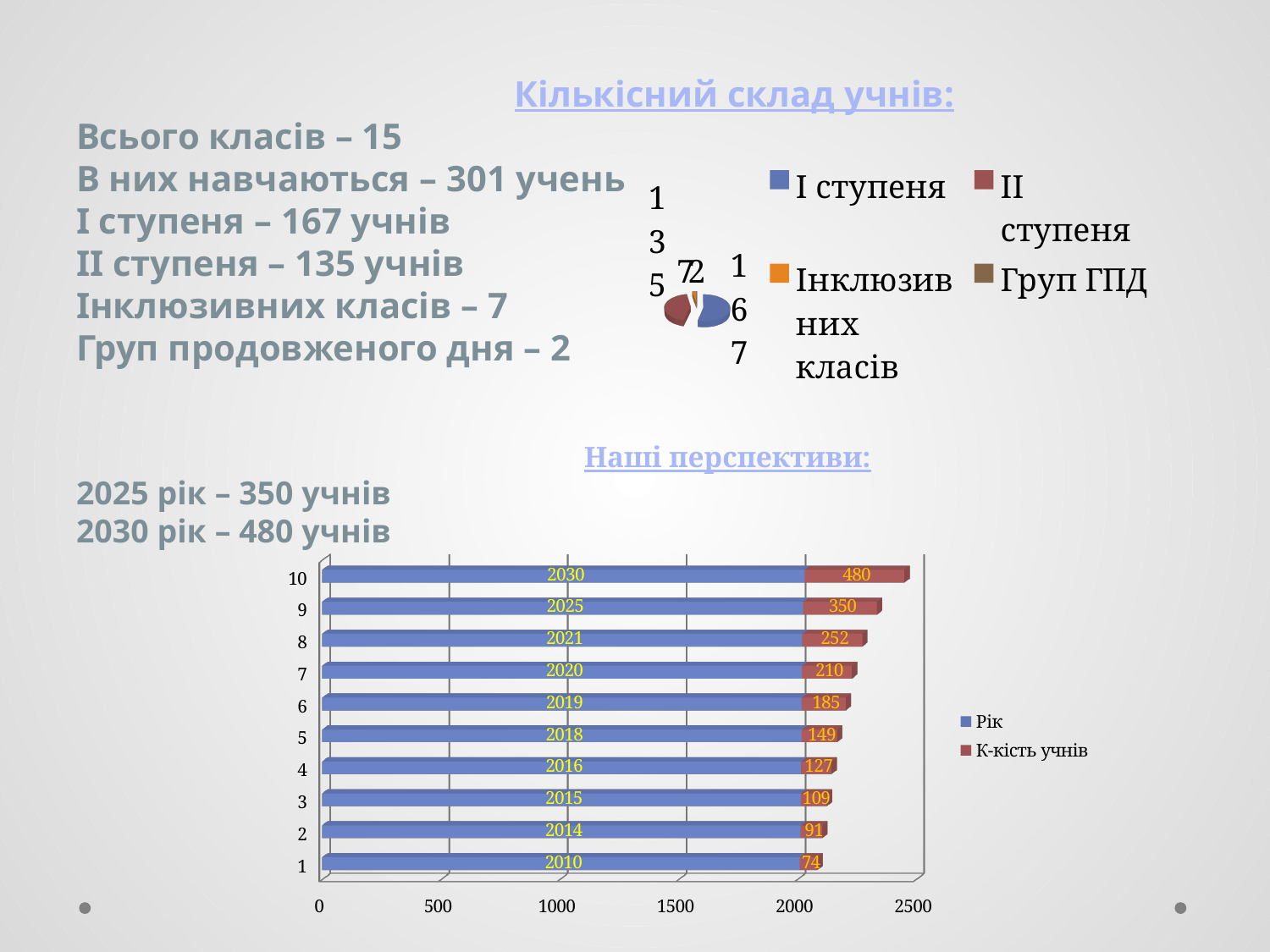
In the bottom bar chart, which category has the larger "К-кість учнів" value, category 8 or category 7? 8 In the bottom bar chart, what is the total of the stacked bar for category 10? 2510 How many entries does the legend of the pie chart under "Кількісний склад учнів:" list? 4 In the bottom bar chart, what is the value of "Рік" for category 5? 2018 In the bottom bar chart, what is the value of "К-кість учнів" for category 10? 480 How many series does the legend of the bottom bar chart list? 2 In the bottom bar chart, what is the value of "К-кість учнів" for category 1? 74 In the bottom bar chart, which category has the lowest value of "К-кість учнів"? 1 How many categories are shown on the vertical axis of the bottom bar chart? 10 In the bottom bar chart, which category has the highest value of "К-кість учнів"? 10 In the bottom bar chart, what is the difference between the "К-кість учнів" values for category 10 and category 9? 130 What kind of chart is the bottom chart under "Наші перспективи:"? bar chart